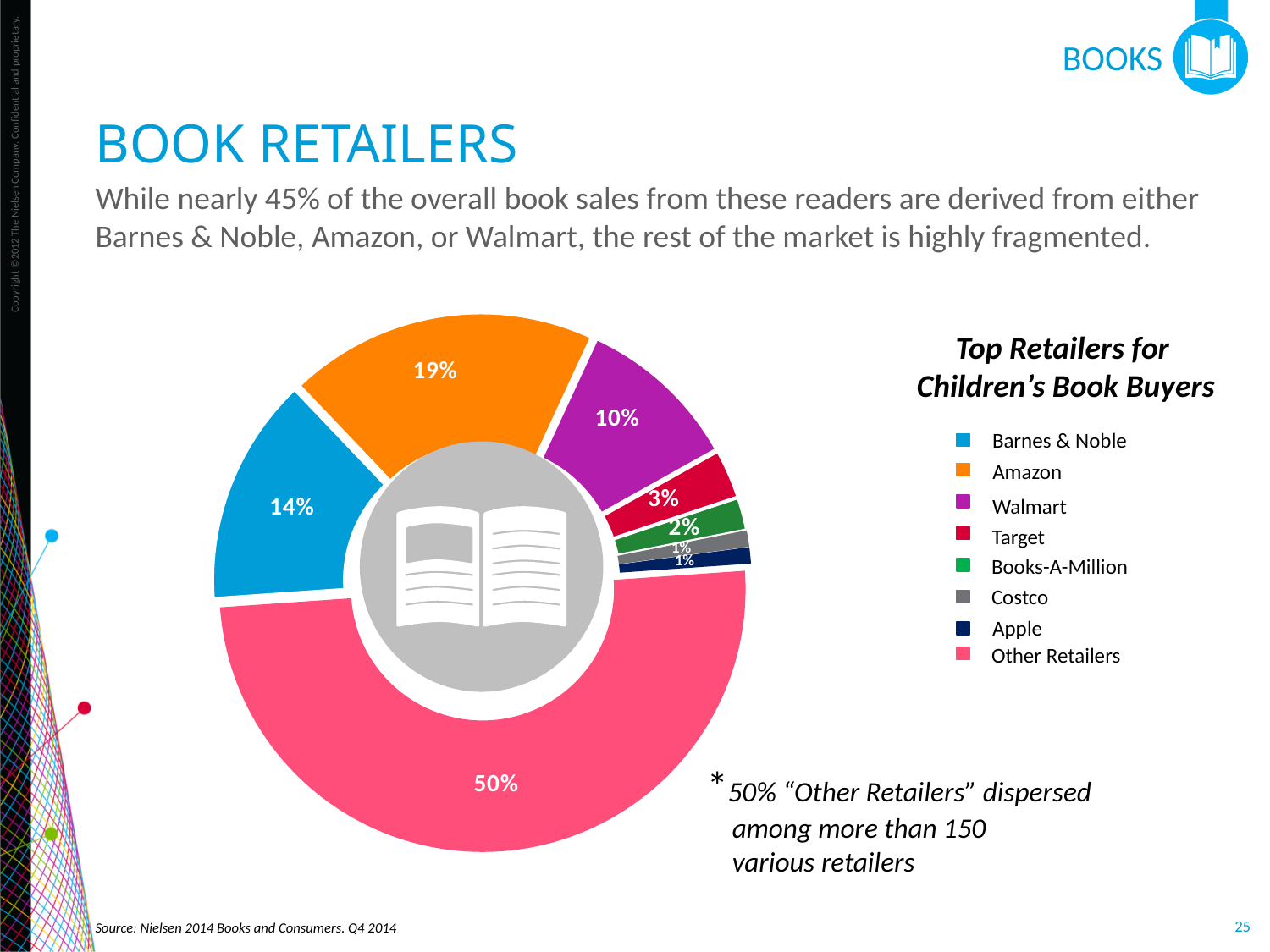
What is the title of the chart? Top Retailers for Children's Book Buyers What share of the pie does Other Retailers hold? 50% What is the difference in share between Amazon and Barnes & Noble? 5% Among the named retailers (excluding Other Retailers), which has the largest share? Amazon What kind of chart is shown on the slide? Doughnut chart Which category has the largest slice of the pie? Other Retailers What share of the pie does Amazon hold? 19% How many categories does the legend list? 8 What share of the pie does Barnes & Noble hold? 14% What share of the pie does Walmart hold? 10% Which has a larger share, Walmart or Target? Walmart What share of the pie does Target hold? 3%